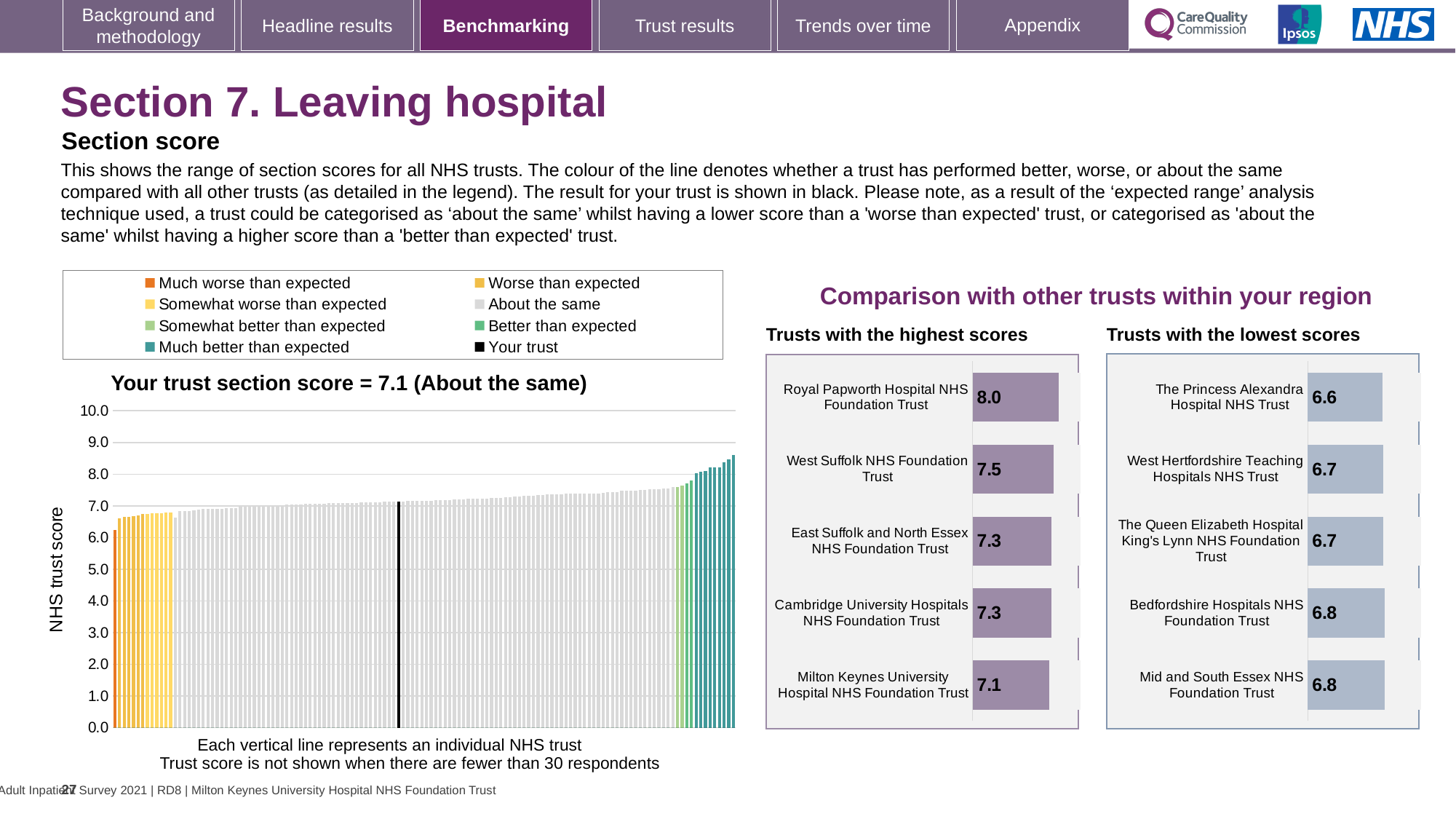
How many entries does the legend above the main chart on the left list? 8 In the 'Trusts with the highest scores' chart, which has the larger score: West Suffolk NHS Foundation Trust or Cambridge University Hospitals NHS Foundation Trust? West Suffolk NHS Foundation Trust In the 'Trusts with the highest scores' chart, what is the score for West Suffolk NHS Foundation Trust? 7.5 In the 'Trusts with the lowest scores' chart, which trust has the lowest score? The Princess Alexandra Hospital NHS Trust In the 'Trusts with the highest scores' chart, what is the difference between the scores of Royal Papworth Hospital NHS Foundation Trust and Milton Keynes University Hospital NHS Foundation Trust? 0.9 What is the section score for your trust shown in the title of the main chart on the left? 7.1 What kind of chart is the main chart on the left showing NHS trust scores? Bar chart How many trusts are listed in the 'Trusts with the lowest scores' chart? 5 In the 'Trusts with the highest scores' chart, which trust has the highest score? Royal Papworth Hospital NHS Foundation Trust In the 'Trusts with the lowest scores' chart, what is the score for Bedfordshire Hospitals NHS Foundation Trust? 6.8 In the 'Trusts with the lowest scores' chart, what is the score for The Princess Alexandra Hospital NHS Trust? 6.6 In the 'Trusts with the highest scores' chart, what is the score for Royal Papworth Hospital NHS Foundation Trust? 8.0